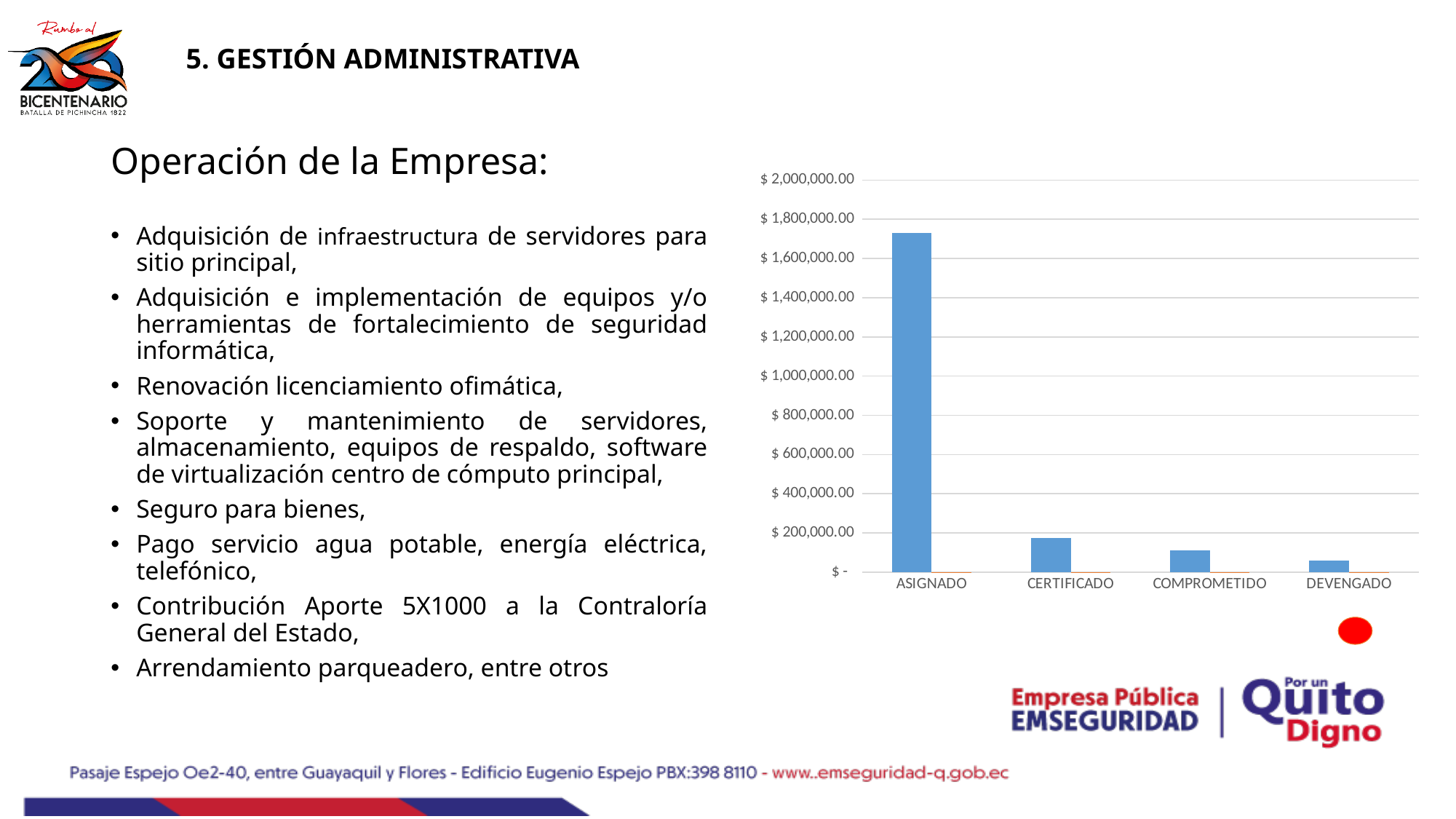
Is the value for ASIGNADO greater or less than $ 1,600,000.00? greater Is the value for CERTIFICADO greater or less than $ 200,000.00? less Is the value for ASIGNADO greater or less than $ 1,800,000.00? less Which is larger, the value for CERTIFICADO or the value for DEVENGADO? CERTIFICADO Do the bar values rise or fall from ASIGNADO to DEVENGADO along the x axis? fall How many categories are shown on the x axis of the chart? 4 Which category has the highest value in the chart? ASIGNADO Which category has the lowest value in the chart? DEVENGADO What is the highest value labelled on the y axis of the chart? $ 2,000,000.00 What kind of chart is shown on the slide? bar chart